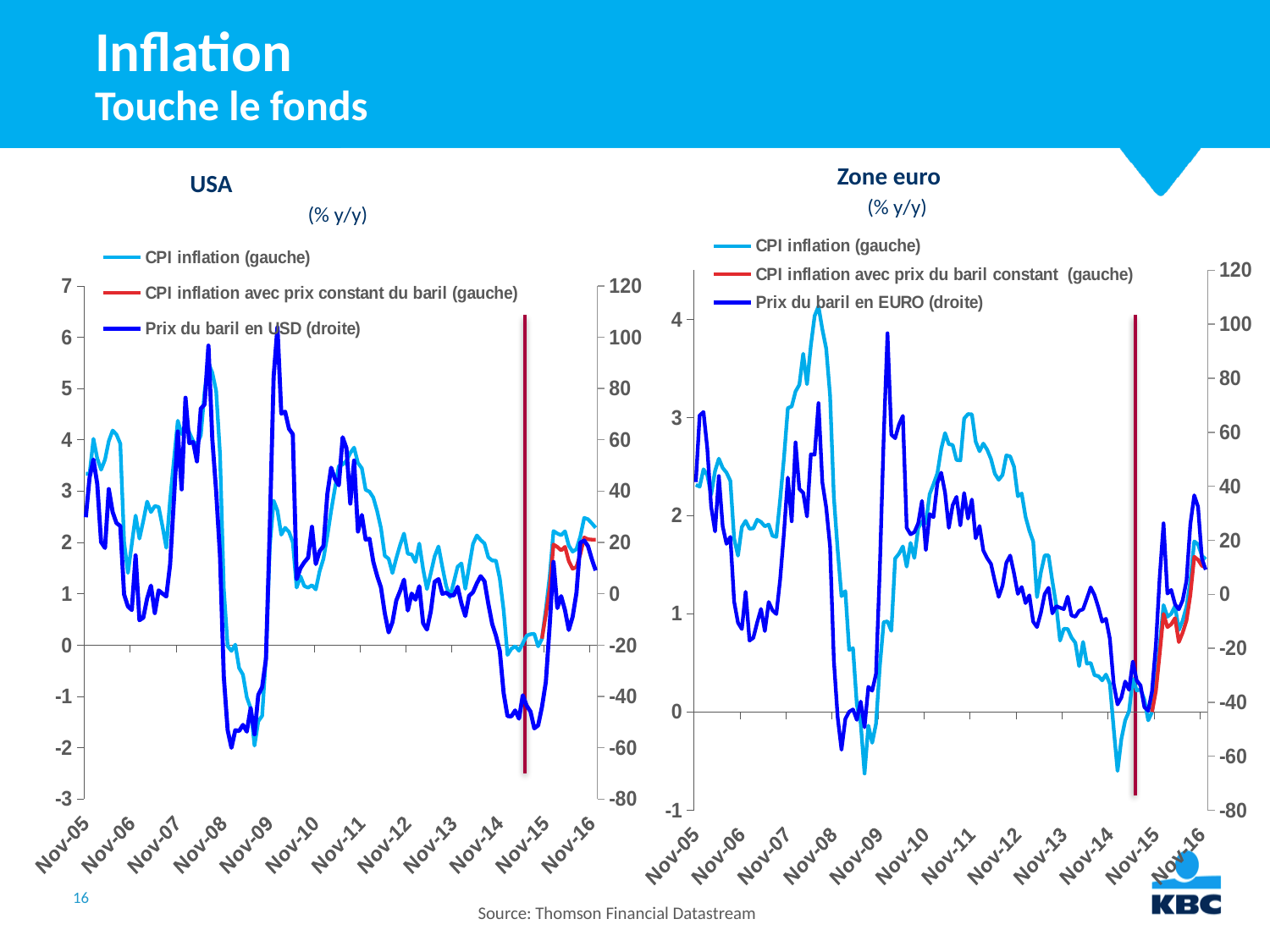
In the USA chart, is the lowest value of CPI inflation around Nov-09 greater or less than -1? less In the Zone euro chart, is the lowest value of CPI inflation around Nov-09 greater or less than 0? less In the Zone euro chart, which series is plotted on the right axis according to the legend? Prix du baril en EURO (droite) In the USA chart, is the peak value of CPI inflation around Nov-08 greater or less than 5? greater In the USA chart, which series is plotted on the right axis according to the legend? Prix du baril en USD (droite) How many series does the legend of the USA chart list? 3 What kind of chart is the USA chart? line chart In the Zone euro chart, does CPI inflation rise or fall between Nov-11 and Nov-14? fall How many date labels are shown on the x axis of the USA chart? 12 In the USA chart, does the Prix du baril en USD series rise or fall between Nov-08 and Nov-09? rise How many series does the legend of the Zone euro chart list? 3